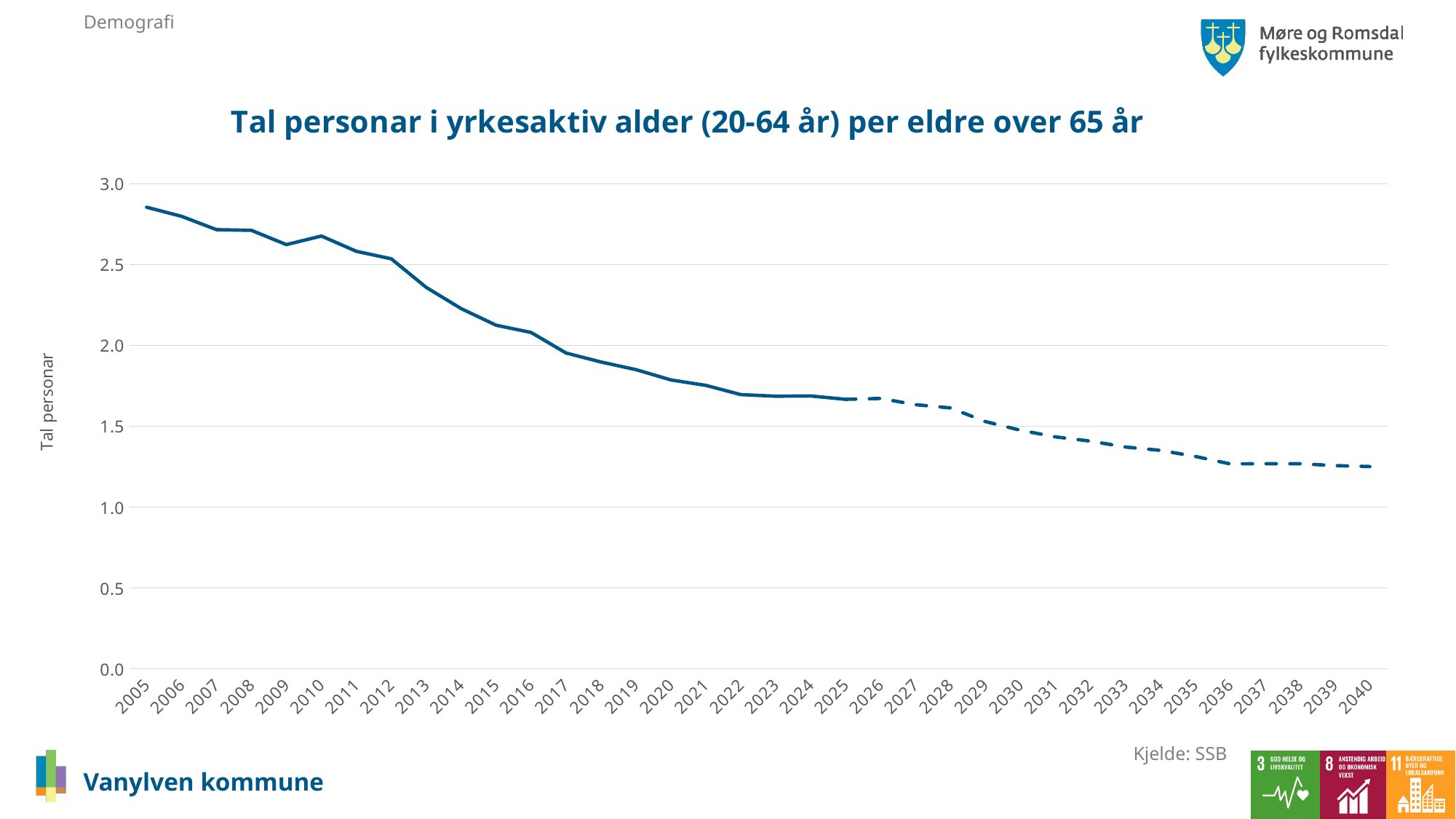
Is the value for 2015 greater or less than 2.0? greater Is the value for 2005 greater or less than 2.5? greater What kind of chart is shown on the slide? line chart How many years are shown along the x axis of the chart? 36 Which year has the highest value in the chart? 2005 Is the value for 2040 greater or less than 1.5? less What is the label on the vertical axis of the chart? Tal personar What is the title of the chart? Tal personar i yrkesaktiv alder (20-64 år) per eldre over 65 år Do the values rise or fall from 2005 to 2040? fall